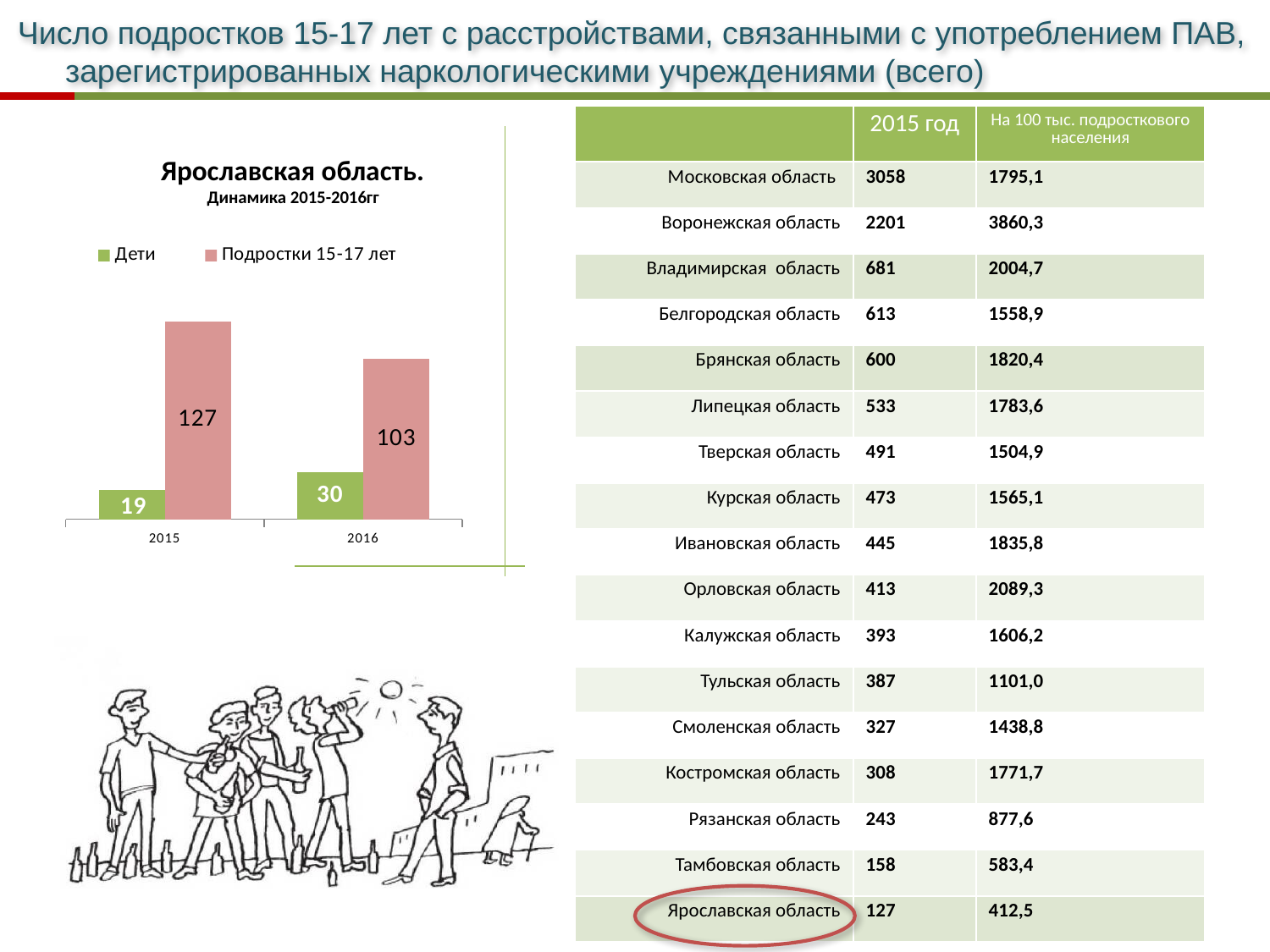
In which year is the value for Подростки 15-17 лет higher? 2015 What is the value for Дети in 2015? 19 What type of chart is shown on the slide? Bar chart What is the value for Подростки 15-17 лет in 2015? 127 How many years are shown on the x axis of the chart? 2 Which is larger: Дети in 2016 or Дети in 2015? Дети in 2016 What is the value for Дети in 2016? 30 What is the value for Подростки 15-17 лет in 2016? 103 How many series does the chart legend list? 2 In which year is the value for Дети lower? 2015 Does the value for Подростки 15-17 лет rise or fall from 2015 to 2016? Fall What is the difference between the Подростки 15-17 лет values for 2015 and 2016? 24